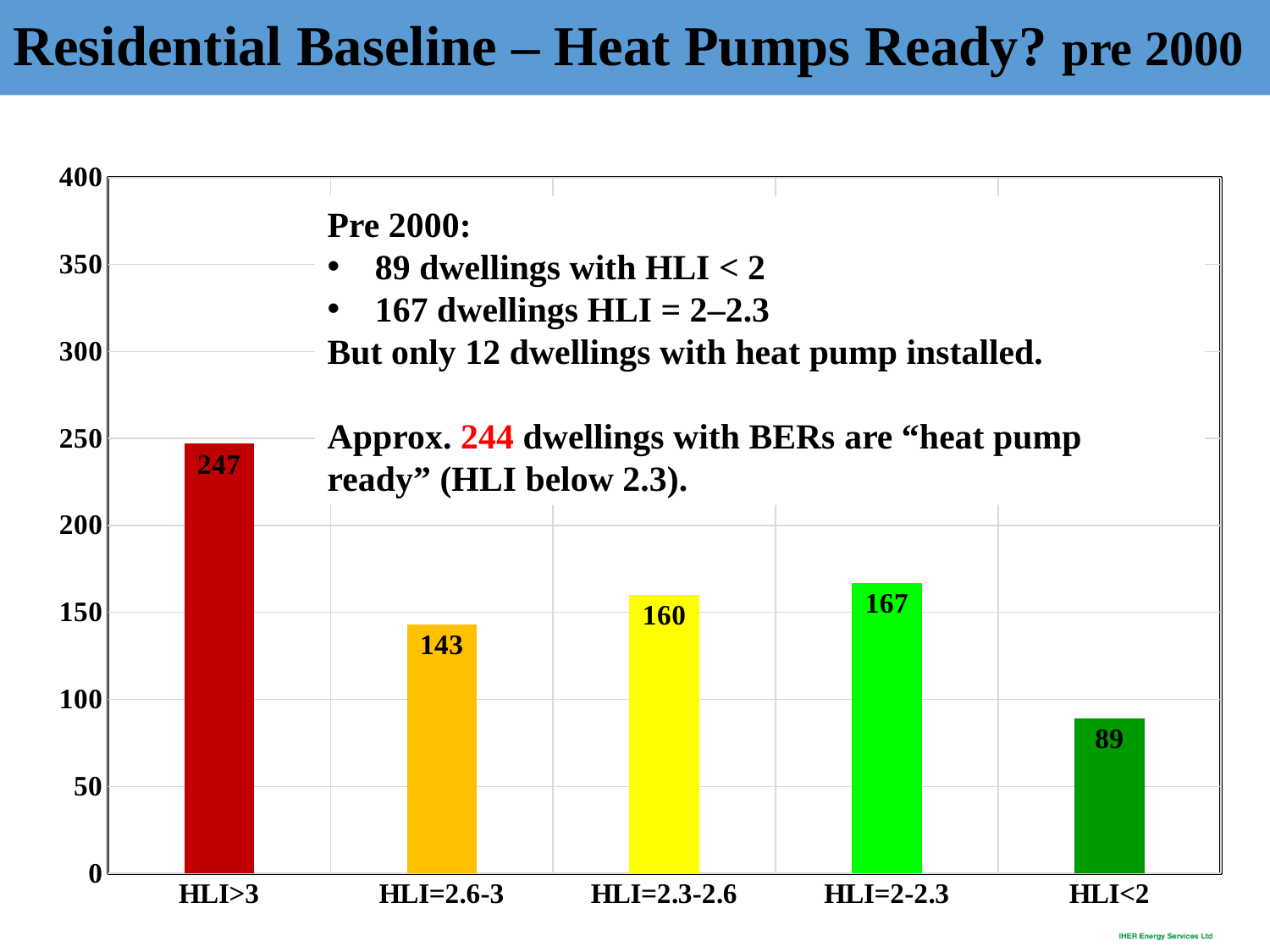
What is the difference between the values for HLI=2.3-2.6 and HLI<2? 71 Is the value for HLI=2-2.3 greater or less than 150? greater How many categories are shown on the x axis? 5 What is the value for HLI=2.6-3? 143 What kind of chart is shown on the slide? bar chart What colour is the bar for HLI<2? green What is the value for HLI>3? 247 Which is larger, the value for HLI=2.6-3 or the value for HLI=2.3-2.6? HLI=2.3-2.6 Which category has the highest value? HLI>3 Which category has the lowest value? HLI<2 What is the difference between the values for HLI>3 and HLI=2-2.3? 80 What is the value for HLI<2? 89